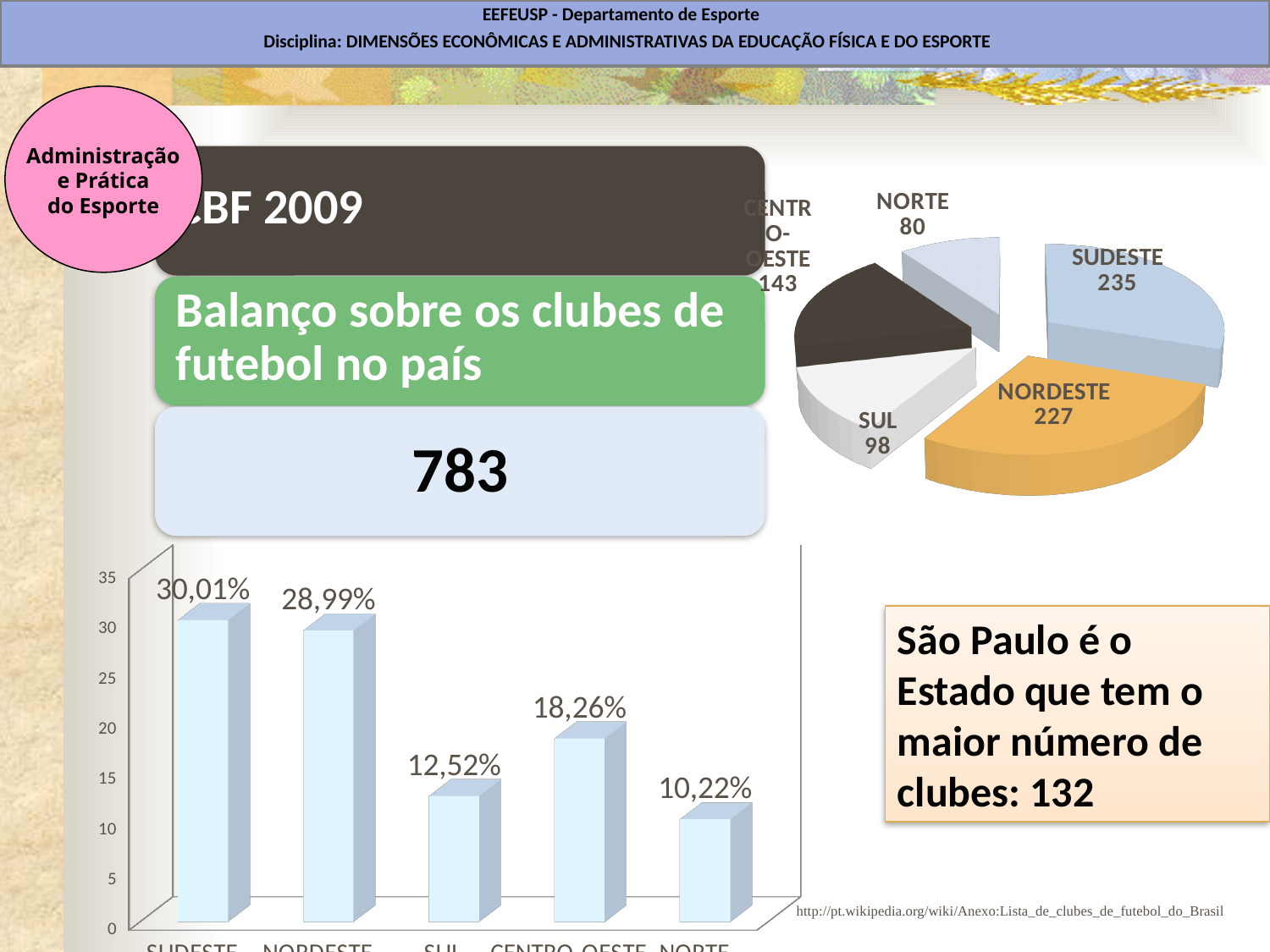
In the bar chart at the bottom left, what is the difference between the first bar (30,01%) and the second bar (28,99%)? 1,02% In the bar chart at the bottom left, what is the value of the first (leftmost) bar? 30,01% In the pie chart, how many clubs does the SUDESTE slice show? 235 In the pie chart, what is the difference between the SUDESTE and SUL values? 137 In the pie chart, what value is shown for NORDESTE? 227 How many slices does the pie chart have? 5 In the pie chart, which is larger, the value for SUL or the value for NORTE? SUL In the bar chart at the bottom left, what is the value of the fourth bar? 18,26% In the pie chart, which region has the smallest slice? NORTE In the pie chart, which region has the largest slice? SUDESTE In the pie chart, what value is shown for NORTE? 80 What kind of chart is shown at the bottom left of the slide? bar chart